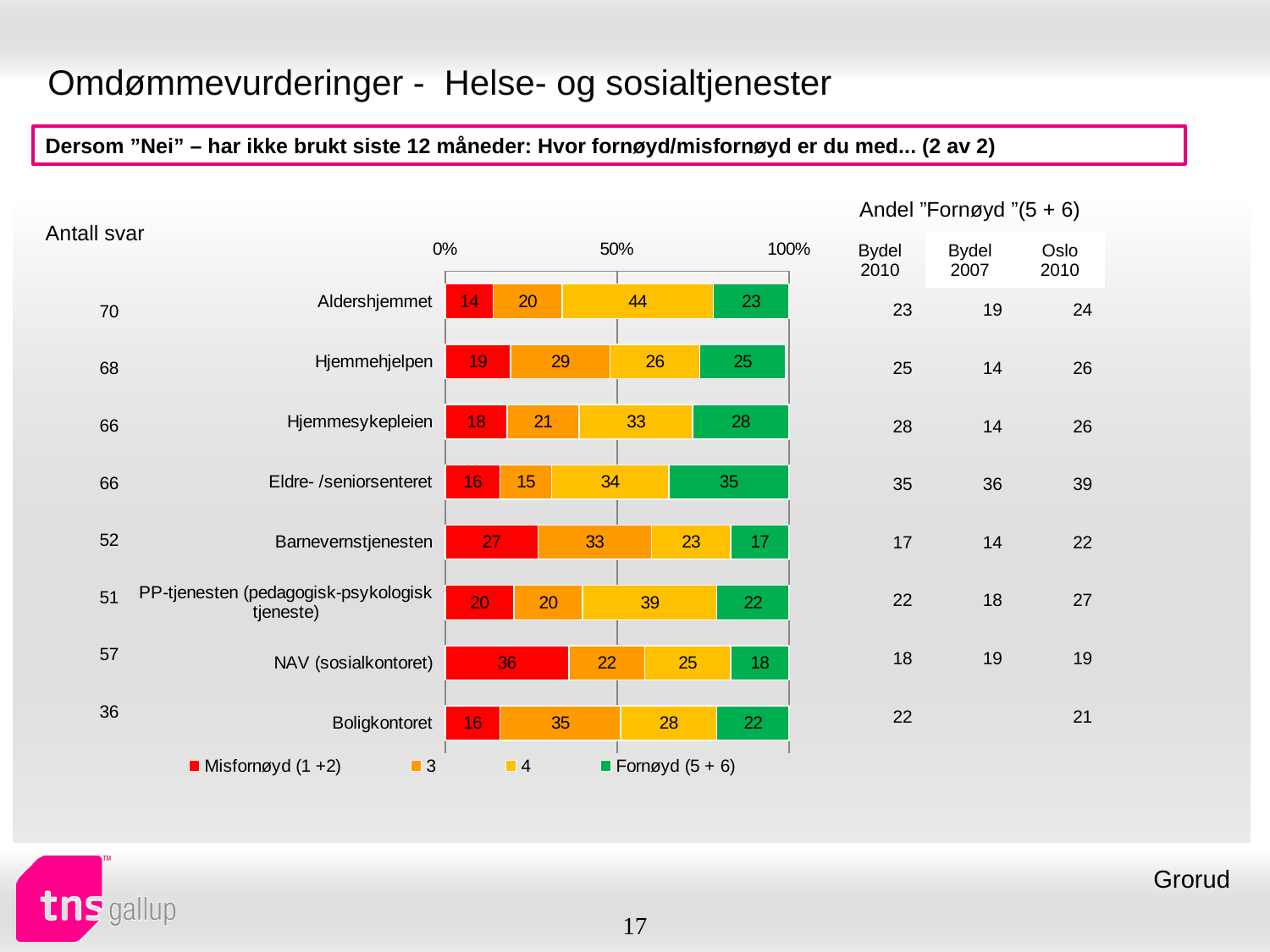
What is the value of the Misfornøyd (1 +2) segment for NAV (sosialkontoret)? 36 Which category has the lowest Fornøyd (5 + 6) value? Barnevernstjenesten How many categories are shown in the bar chart? 8 Which category has the highest Fornøyd (5 + 6) value? Eldre- /seniorsenteret What is the first entry in the chart legend? Misfornøyd (1 +2) What is the value of the Fornøyd (5 + 6) segment for Hjemmesykepleien? 28 How many series does the legend list? 4 Which category has the highest Misfornøyd (1 +2) value? NAV (sosialkontoret) What is the value of the '3' segment for Boligkontoret? 35 Which has a larger '4' segment value, Aldershjemmet or PP-tjenesten (pedagogisk-psykologisk tjeneste)? Aldershjemmet What kind of chart is shown on the slide? Stacked bar chart What is the difference between the Fornøyd (5 + 6) values for Eldre- /seniorsenteret and Barnevernstjenesten? 18